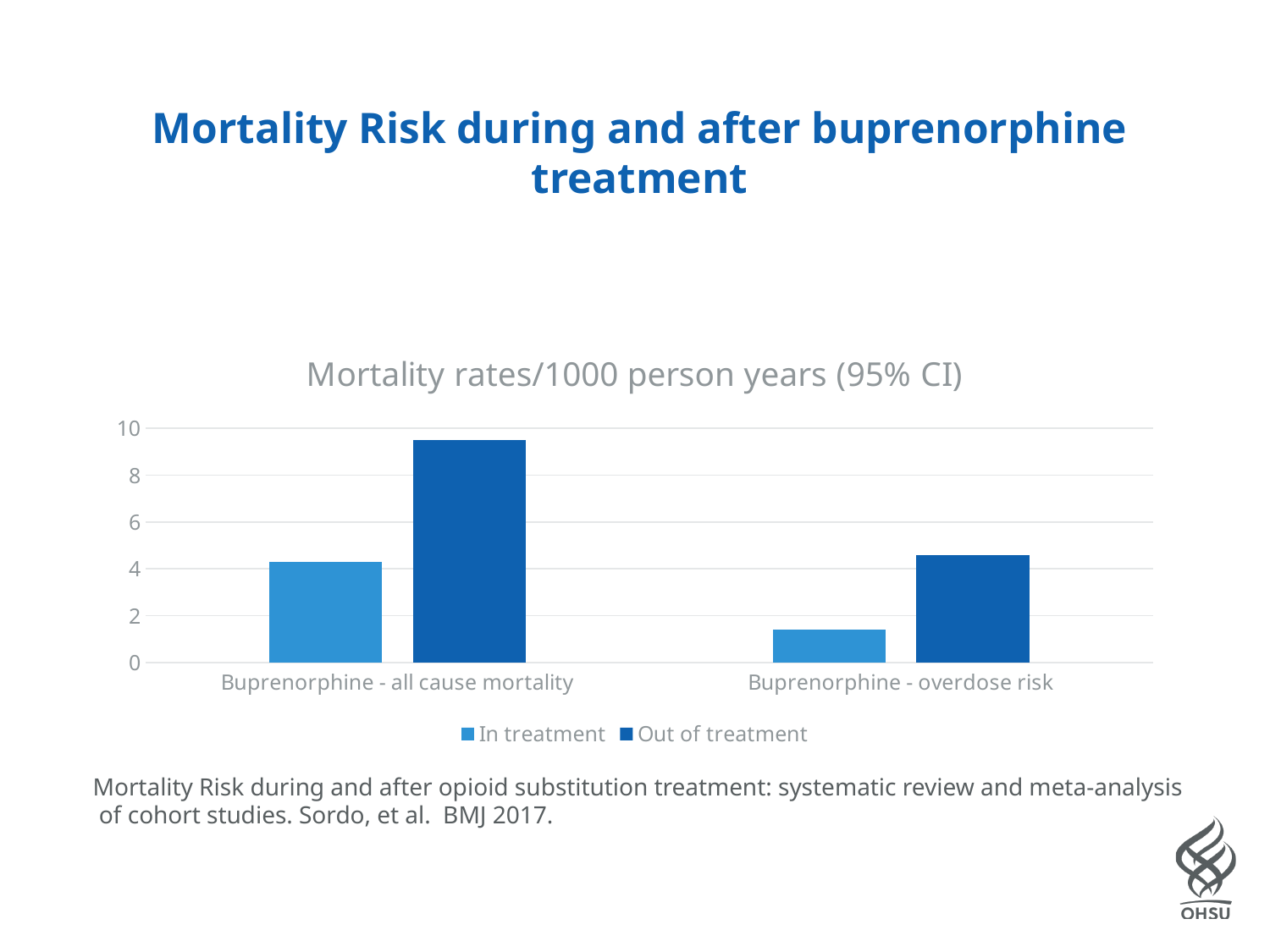
For Buprenorphine - overdose risk, which is larger: In treatment or Out of treatment? Out of treatment Which series is shown in the darker blue colour? Out of treatment Is the In treatment value for Buprenorphine - all cause mortality greater or less than 6? less How many series does the legend list? 2 Is the Out of treatment value for Buprenorphine - overdose risk greater or less than 4? greater Is the In treatment value for Buprenorphine - overdose risk greater or less than 2? less Which bar is the lowest in the chart? In treatment, Buprenorphine - overdose risk What kind of chart is shown on the slide? bar chart Which bar is the highest in the chart? Out of treatment, Buprenorphine - all cause mortality How many categories are shown on the x axis? 2 What is the title of the chart? Mortality rates/1000 person years (95% CI)